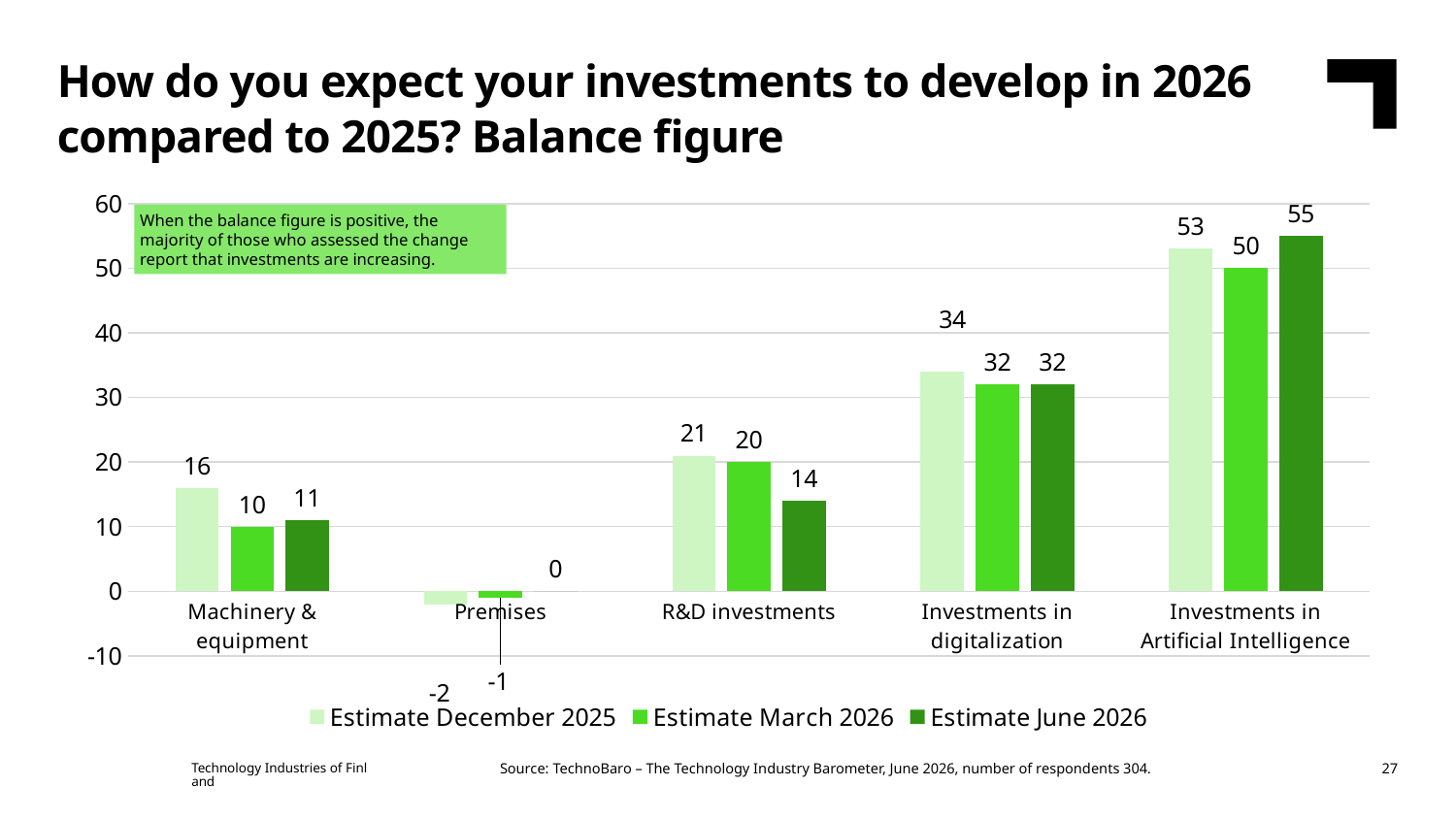
Which category has the lowest Estimate December 2025 value? Premises What is the name of the third series in the legend? Estimate June 2026 Which category has the highest Estimate June 2026 value? Investments in Artificial Intelligence Which is larger for Investments in digitalization: the Estimate December 2025 value or the Estimate March 2026 value? Estimate December 2025 What is the Estimate March 2026 value for Premises? -1 How many categories are shown on the x axis? 5 What is the difference between the Estimate December 2025 and Estimate June 2026 values for R&D investments? 7 Do the Estimate June 2026 values for R&D investments, Investments in digitalization and Investments in Artificial Intelligence rise or fall from left to right? Rise What is the Estimate December 2025 value for Machinery & equipment? 16 How many series does the legend list? 3 What kind of chart is shown on the slide? Bar chart What is the Estimate June 2026 value for Investments in Artificial Intelligence? 55